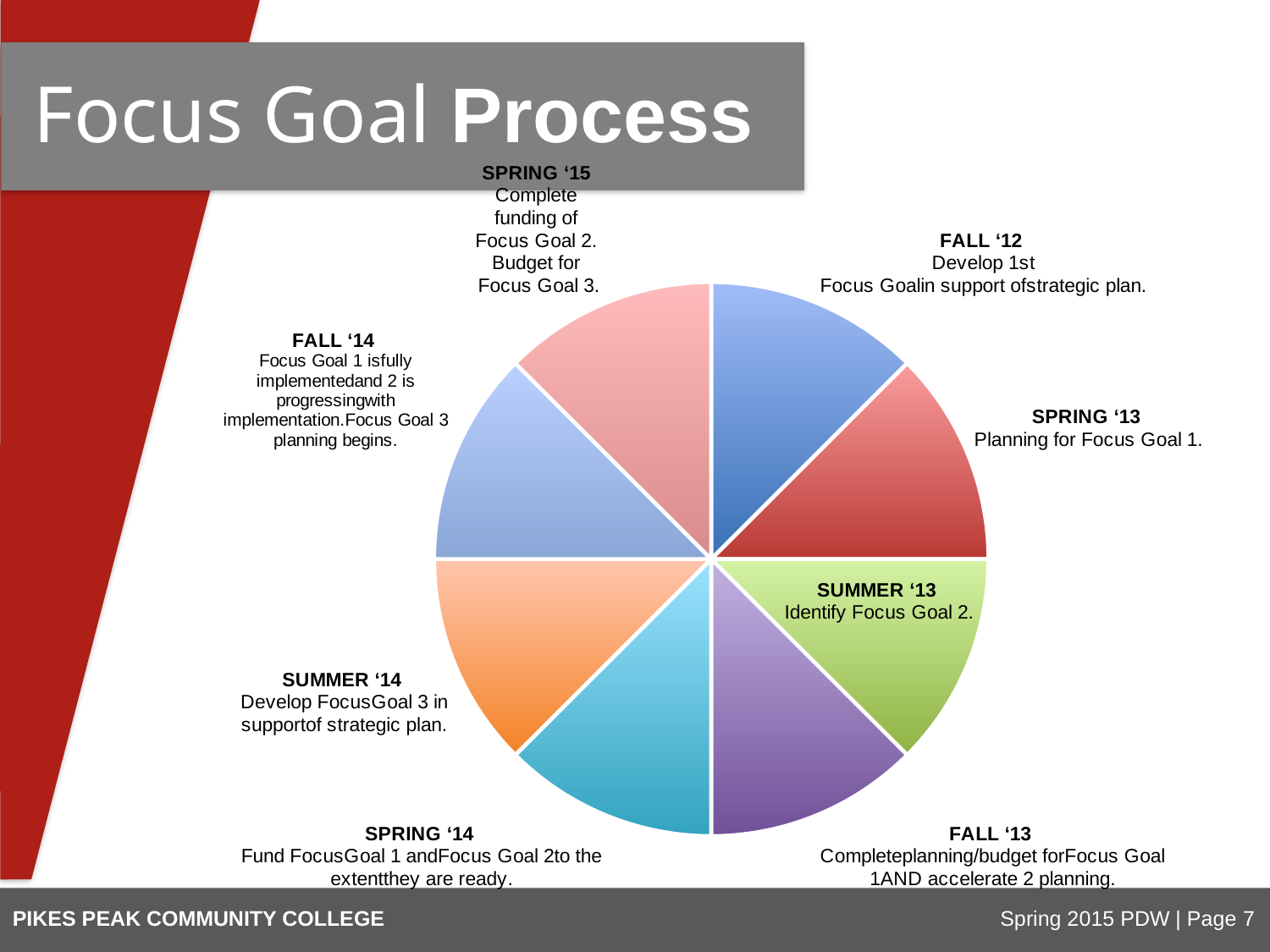
Which term's slice is labeled 'Complete funding of Focus Goal 2. Budget for Focus Goal 3'? SPRING '15 Which slice label describes 'Planning for Focus Goal 1'? SPRING '13 What kind of chart is shown on the slide? pie chart What is the earliest term labeled on the pie chart? FALL '12 Which slice label describes 'Identify Focus Goal 2'? SUMMER '13 Which term's slice is labeled 'Fund Focus Goal 1 and Focus Goal 2 to the extent they are ready'? SPRING '14 What is the latest term labeled on the pie chart? SPRING '15 How many slices does the pie chart have? 8 Which term's slice is labeled 'Develop Focus Goal 3 in support of strategic plan'? SUMMER '14 What is the title of the slide containing the pie chart? Focus Goal Process What colour is the SUMMER '13 slice of the pie chart? green